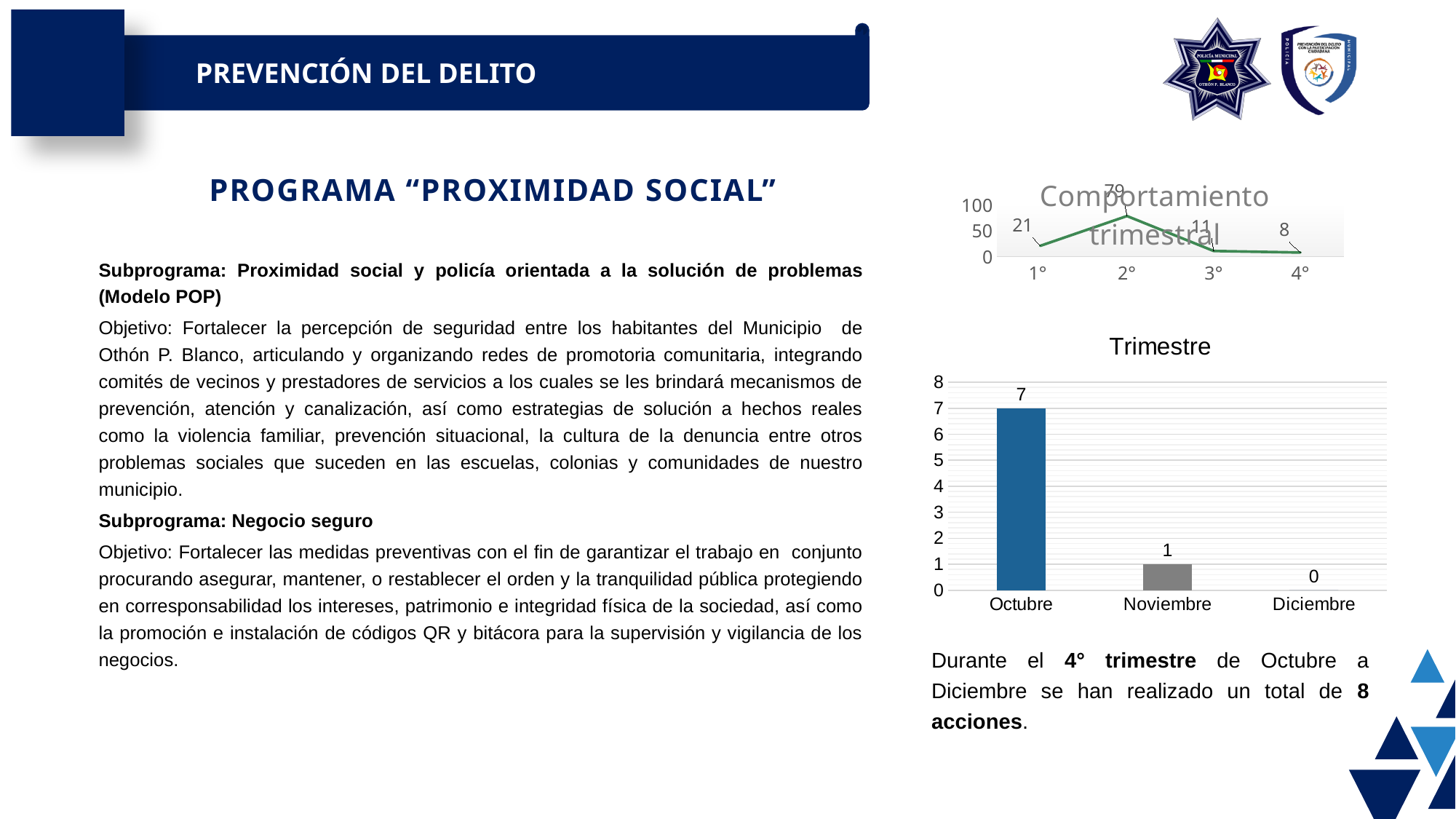
In the "Comportamiento trimestral" line chart, what is the value for 4°? 8 What kind of chart is the "Trimestre" chart? Bar chart In the "Comportamiento trimestral" line chart, is the value for 3° larger or smaller than the value for 1°? smaller In the "Trimestre" bar chart, what is the value for Noviembre? 1 In the "Trimestre" bar chart, what is the difference between the values for Octubre and Noviembre? 6 In the "Trimestre" bar chart, what is the value for Octubre? 7 In the "Trimestre" bar chart, which month has the highest value? Octubre In the "Trimestre" bar chart, which month has the lowest value? Diciembre In the "Comportamiento trimestral" line chart, which quarter has the highest value? 2° In the "Trimestre" bar chart, how many months are shown on the x axis? 3 In the "Comportamiento trimestral" line chart, what is the value for 1°? 21 In the "Trimestre" bar chart, what is the value for Diciembre? 0